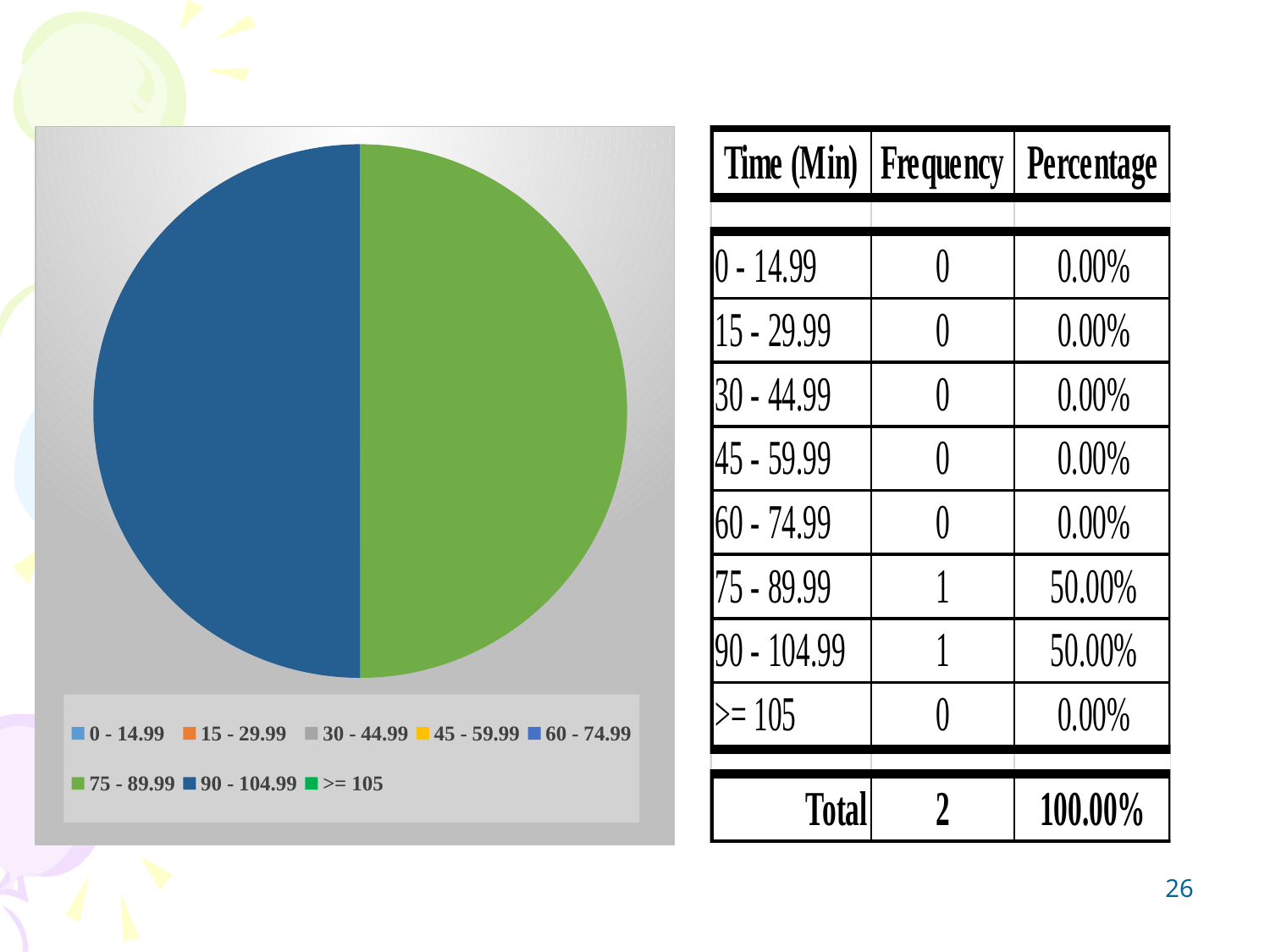
Which colour represents the 75 - 89.99 category in the pie chart? green What is the frequency for the 75 - 89.99 category? 1 What is the total frequency across all categories? 2 What share of the pie does the 90 - 104.99 slice represent? 50.00% What is the frequency for the 90 - 104.99 category? 1 Which colour represents the 90 - 104.99 category in the pie chart? dark blue What kind of chart is shown on the slide? pie chart What share of the pie does the 75 - 89.99 slice represent? 50.00% What is the difference in frequency between the 75 - 89.99 and 90 - 104.99 categories? 0 How many categories does the legend of the pie chart list? 8 How many slices are visible in the pie chart? 2 What is the percentage for the 0 - 14.99 category? 0.00%